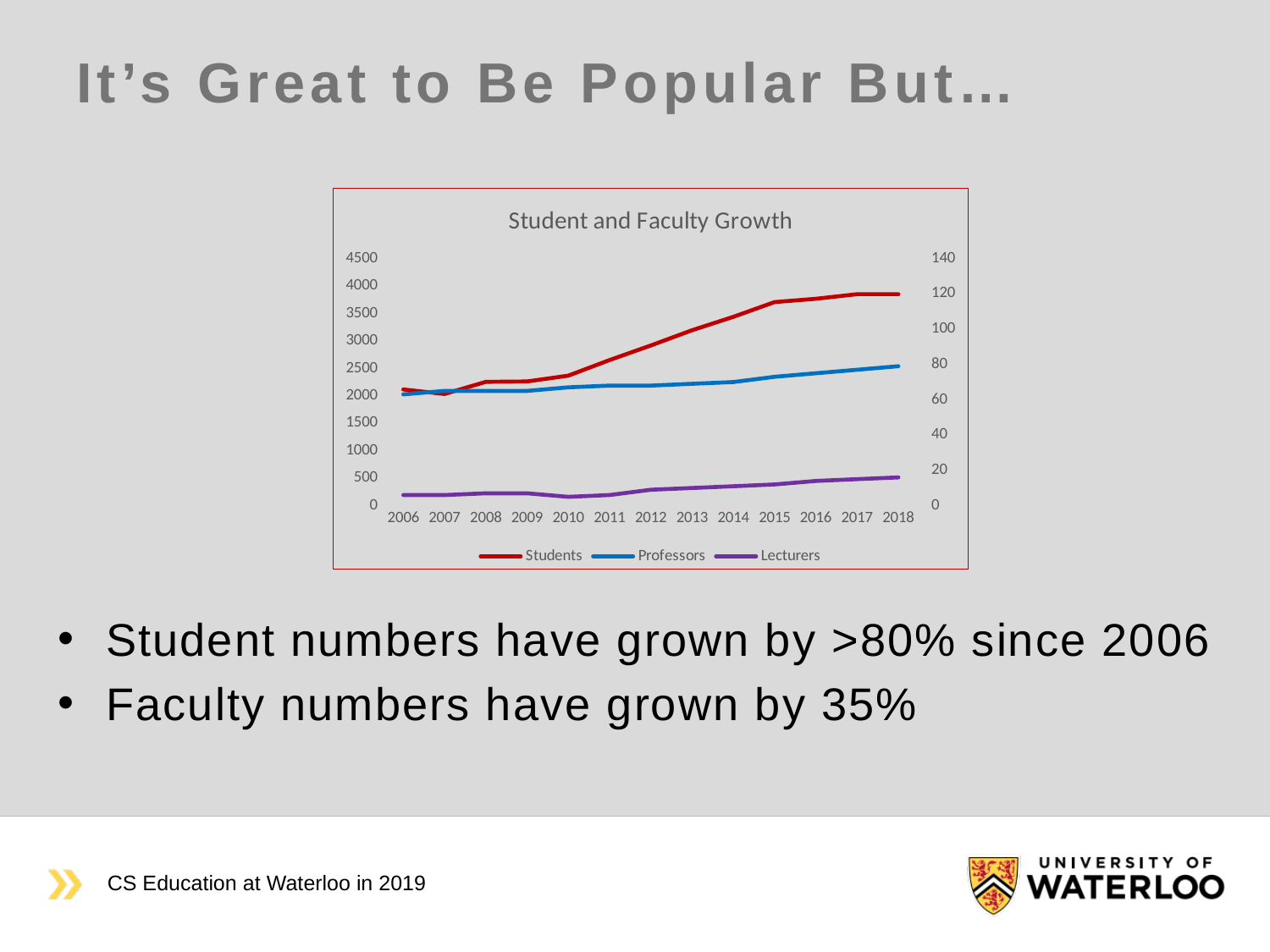
Does the Students line rise or fall from 2006 to 2018? rise In 2018, which series has the larger value on the right axis, Professors or Lecturers? Professors Is the Lecturers value for 2018 greater or less than 40 on the right axis? less Is the Professors value for 2018 greater or less than 100 on the right axis? less How many series does the chart's legend list? 3 How many years are shown along the x axis of the chart? 13 Is the Students value for 2010 greater or less than 3000 on the left axis? less What type of chart is shown on the slide? line chart Is the Students value larger in 2006 or in 2018? 2018 Which series is drawn in red in the chart? Students What is the title of the chart? Student and Faculty Growth